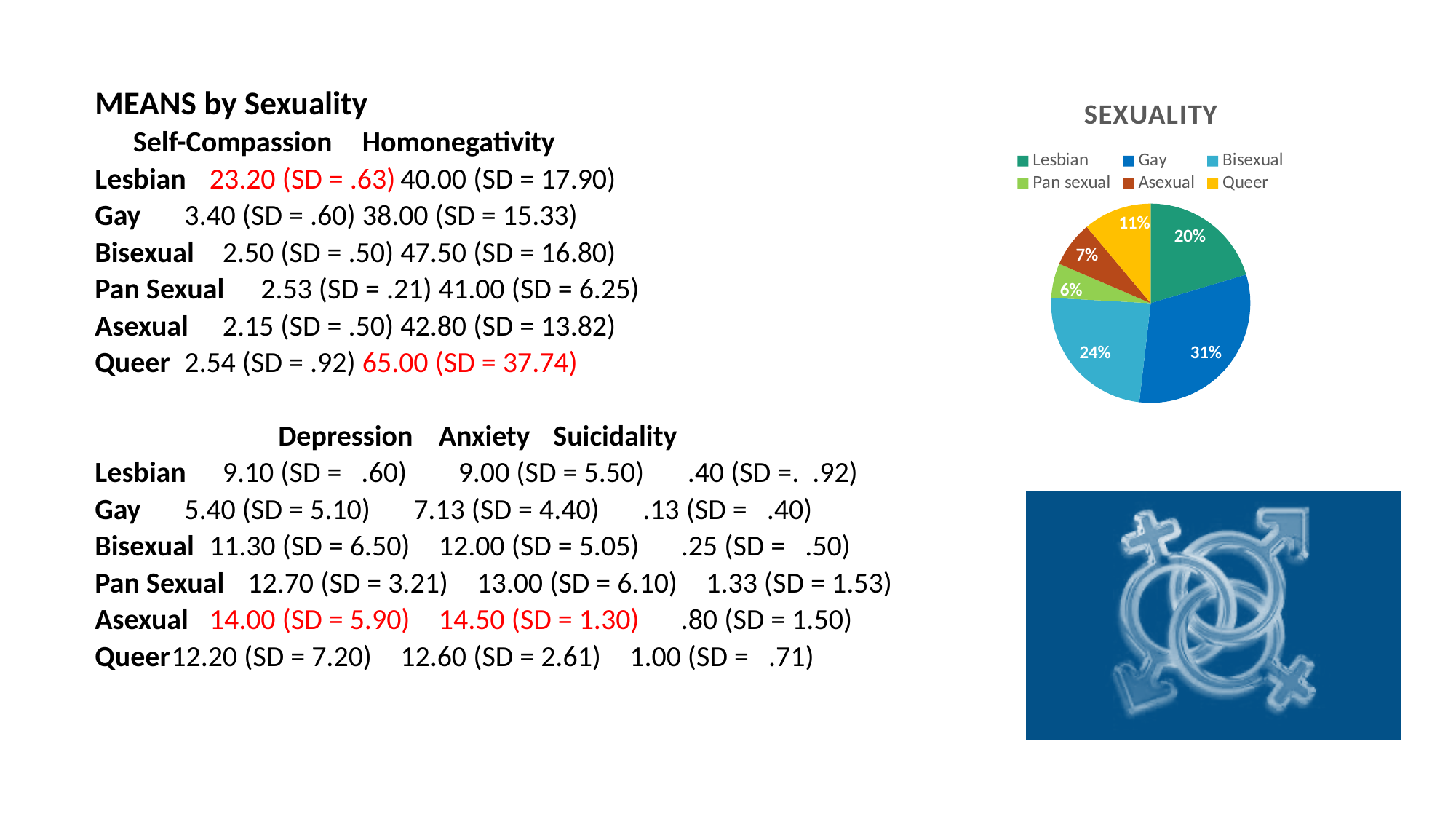
What kind of chart is shown under the title "SEXUALITY"? pie chart In the SEXUALITY pie chart, what share is labelled for Pan sexual? 6% In the SEXUALITY pie chart, what is the difference in percentage points between the Gay and Lesbian slices? 11 In the SEXUALITY pie chart, which slice is larger, Asexual or Queer? Queer In the SEXUALITY pie chart, which category has the largest slice? Gay In the SEXUALITY pie chart, what share is labelled for Lesbian? 20% In the SEXUALITY pie chart, what colour is the Queer slice? yellow In the SEXUALITY pie chart, what share is labelled for Queer? 11% In the SEXUALITY pie chart, what share is labelled for Gay? 31% In the SEXUALITY pie chart, which category has the smallest slice? Pan sexual In the SEXUALITY pie chart, what share is labelled for Bisexual? 24% How many categories does the legend of the SEXUALITY pie chart list? 6